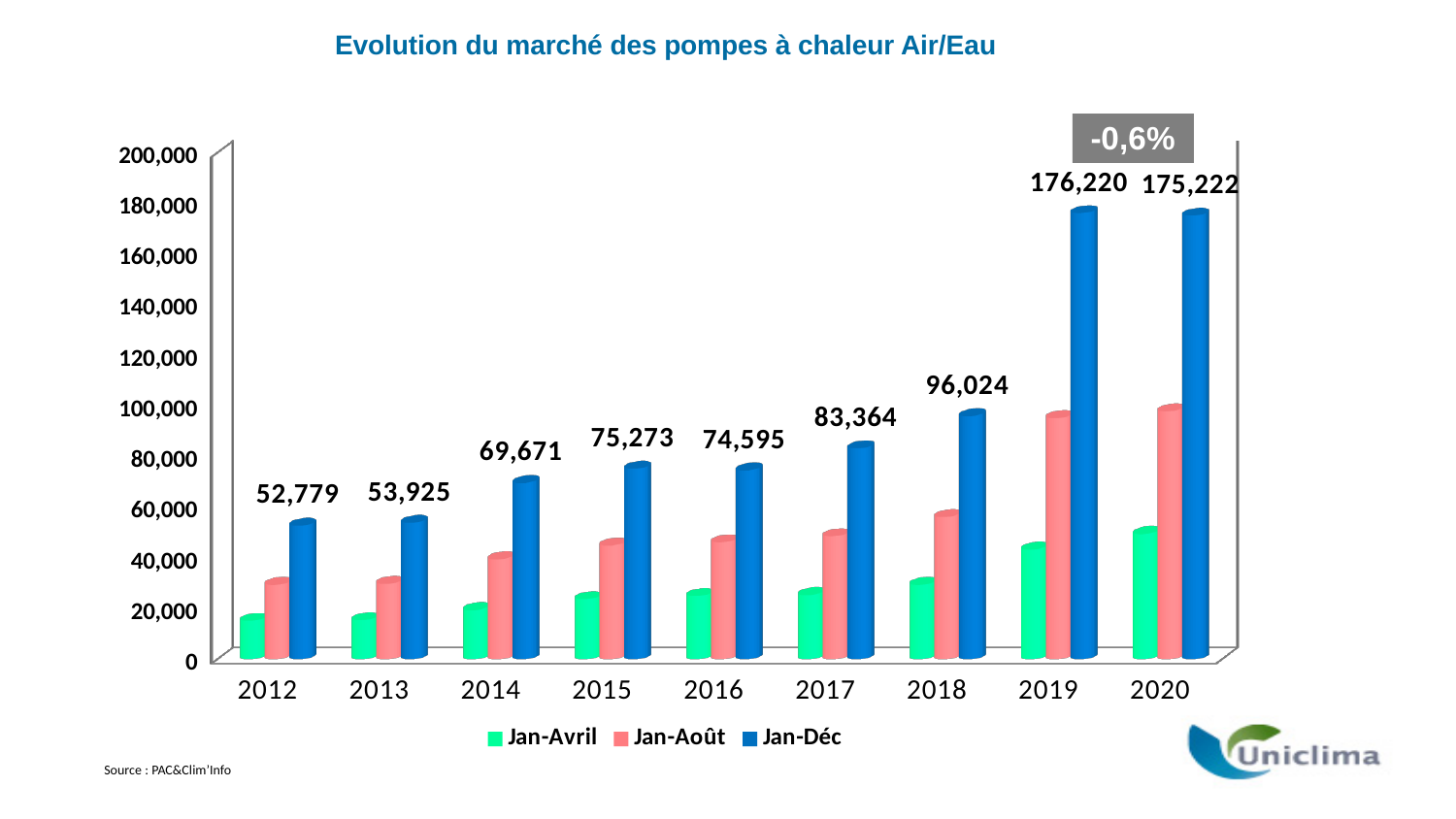
Which year has the lowest Jan-Déc value? 2012 What is the Jan-Déc value for 2019? 176,220 What kind of chart is shown on the slide? Bar chart Which is larger, the Jan-Déc value for 2015 or for 2016? 2015 What is the difference between the Jan-Déc values for 2019 and 2020? 998 Is the Jan-Avril value for 2020 greater or less than 40,000? greater What is the Jan-Déc value for 2014? 69,671 What is the difference between the Jan-Déc values for 2018 and 2017? 12,660 Which year has the highest Jan-Déc value? 2019 How many years are shown on the x axis? 9 How many series does the legend list? 3 What is the Jan-Déc value for 2018? 96,024